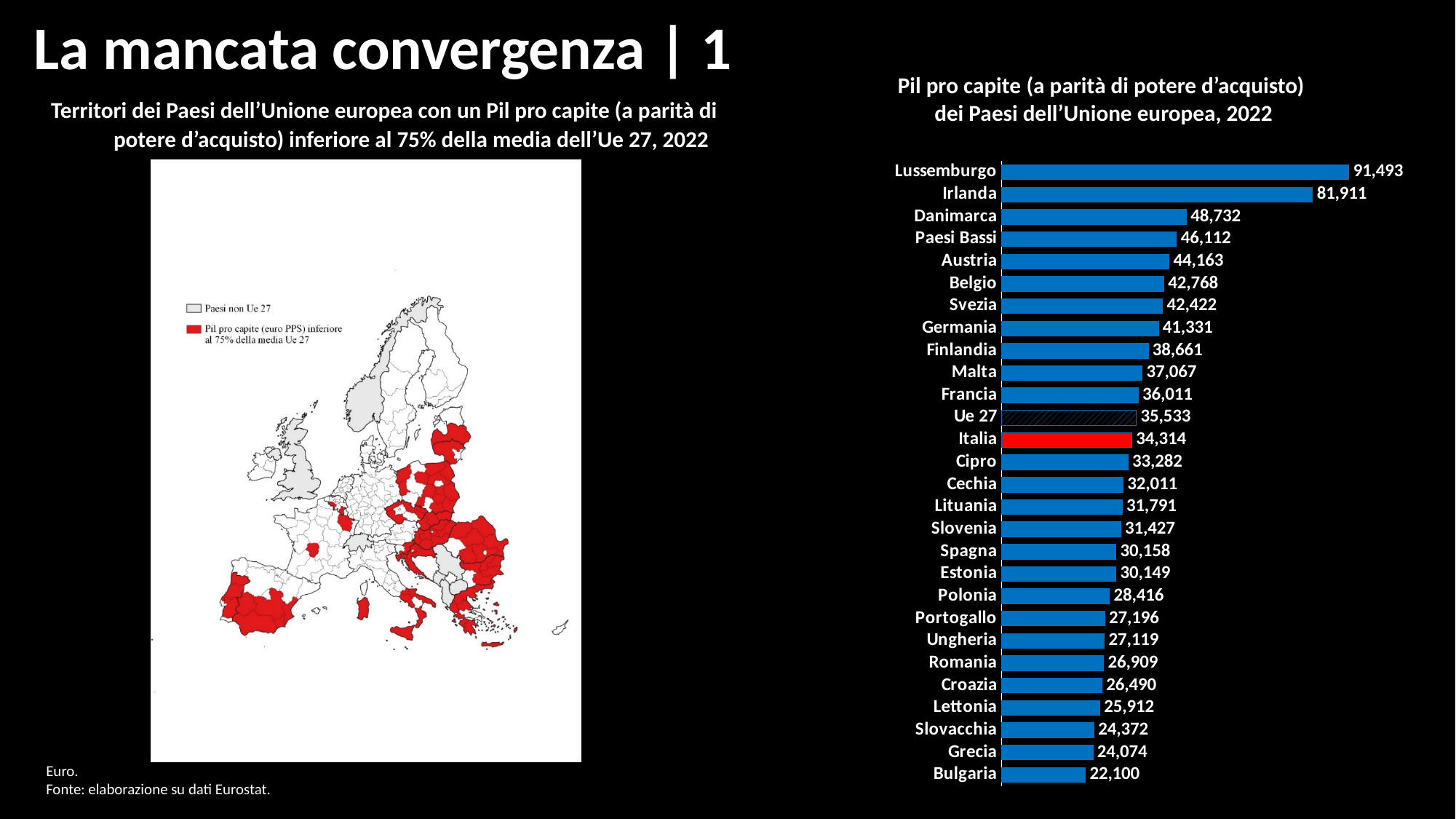
What kind of chart is shown on the right side of the slide? Bar chart How many bars are shown in the bar chart on the right? 28 In the bar chart on the right, which has a higher value, Danimarca or Paesi Bassi? Danimarca In the bar chart on the right, how much lower is Italia's value than the Ue 27 value? 1,219 In the bar chart on the right, which country has the highest Pil pro capite? Lussemburgo In the bar chart on the right, what is the difference between the values for Lussemburgo and Irlanda? 9,582 In the bar chart on the right, what is the value shown for Ue 27? 35,533 In the bar chart on the right, what is the value for Germania? 41,331 In the bar chart on the right, which country has the lowest Pil pro capite? Bulgaria In the bar chart on the right, which bar is coloured red? Italia In the bar chart on the right, which has a higher value, Grecia or Slovacchia? Slovacchia In the bar chart on the right, what is the Pil pro capite value for Italia? 34,314